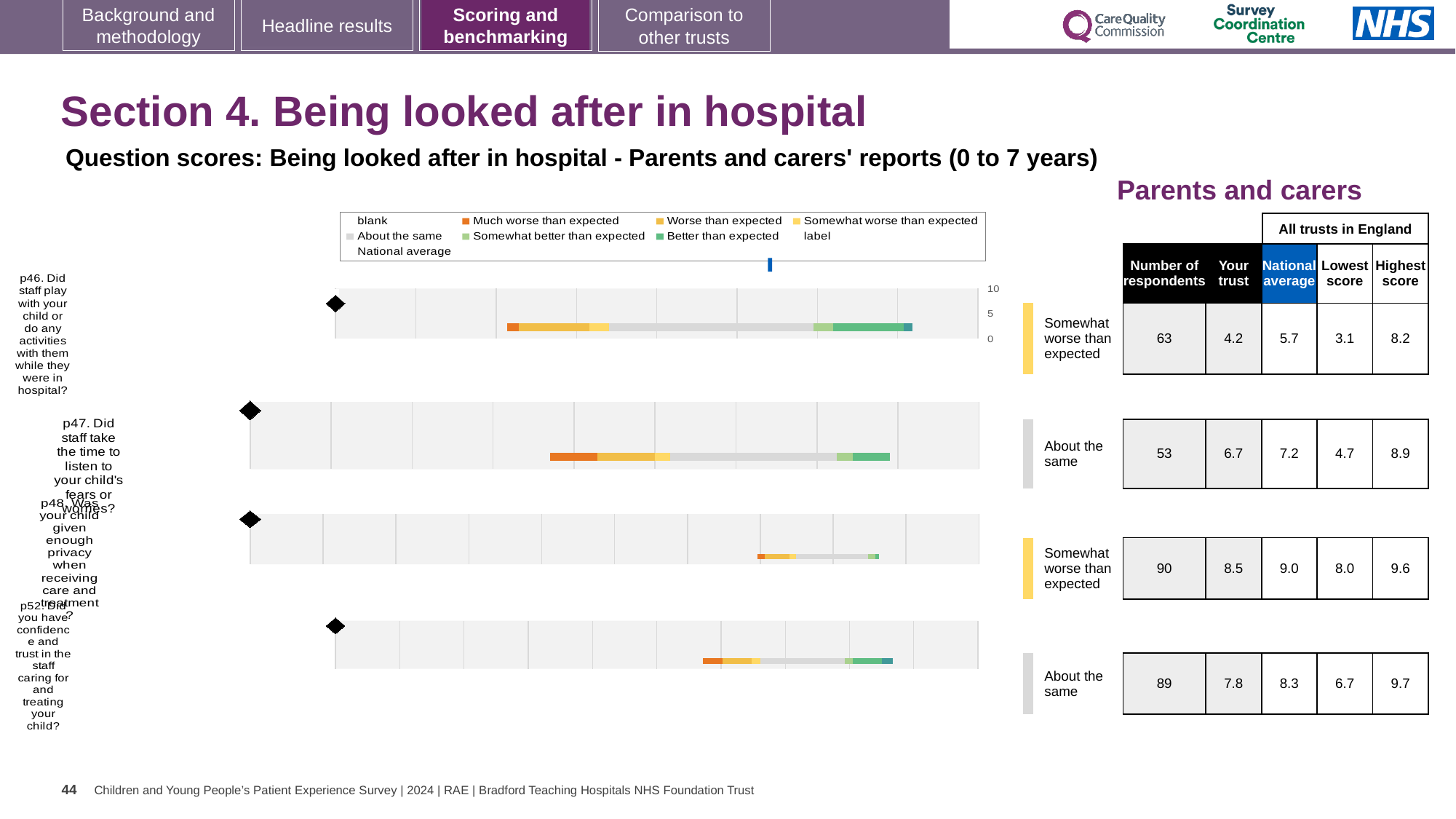
In the table beside the chart, what is the 'Your trust' score for p46 (Did staff play with your child)? 4.2 In the table beside the chart, how many respondents answered p48 (Was your child given enough privacy)? 90 What is the difference between the national average and the 'Your trust' score for p46? 1.5 Which question has the highest 'Your trust' score in the table? p48 In the table beside the chart, what is the national average for p47 (Did staff take the time to listen to your child's fears or worries)? 7.2 In the table beside the chart, what is the highest score across all trusts for p52 (confidence and trust in the staff)? 9.7 How many questions (rows) are charted on the slide? 4 What kind of chart is used to show the question scores on this slide? bar chart Which colour in the legend represents 'Much worse than expected'? orange What is the highest tick value shown on the chart axis? 10 Which question has the lowest 'Your trust' score in the table? p46 For p52, is the 'Your trust' score higher or lower than the national average? lower